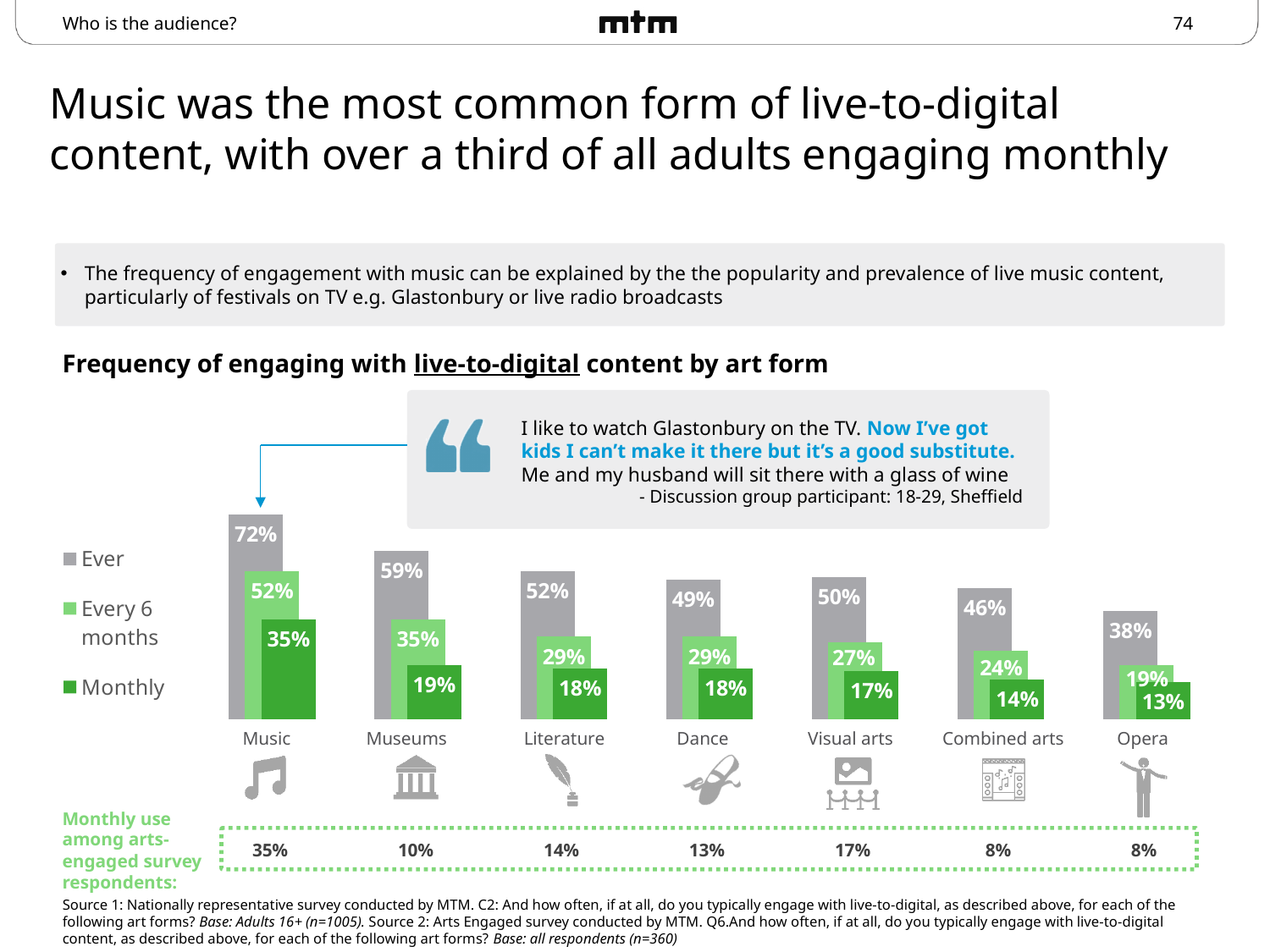
Which art form has the lowest 'Monthly' value? Opera How many art forms are shown on the x axis of the chart? 7 What is the 'Ever' value for Music? 72% What is the difference between the 'Ever' values for Music and Opera? 34% Which art form has the highest 'Ever' value? Music What are the three series listed in the chart legend? Ever, Every 6 months, Monthly What kind of chart is shown on the slide? Bar chart What is the 'Every 6 months' value for Combined arts? 24% How many series does the chart legend list? 3 Do the 'Ever' values generally rise or fall from Music to Opera along the x axis? Fall What is the 'Monthly' value for Museums? 19% Which is larger, the 'Every 6 months' value for Museums or for Visual arts? Museums